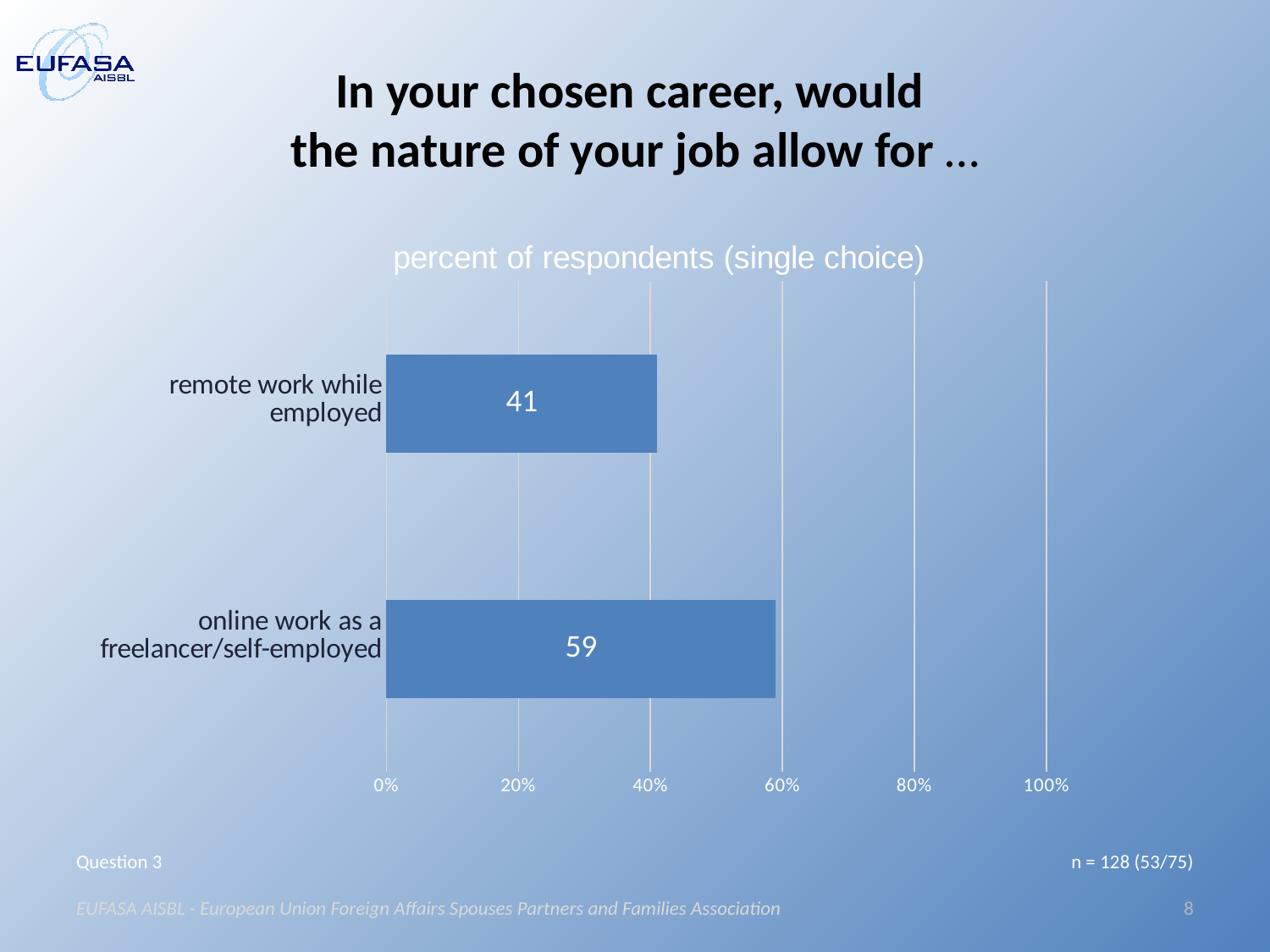
Which is larger: the value for "remote work while employed" or for "online work as a freelancer/self-employed"? online work as a freelancer/self-employed How many categories are shown in the chart? 2 What is the value for "remote work while employed"? 41 What is the maximum value shown on the x axis? 100% What kind of chart is shown on the slide? bar chart Which category has the highest value? online work as a freelancer/self-employed Which category has the lowest value? remote work while employed Is the value for "online work as a freelancer/self-employed" greater or less than 40%? greater What is the value for "online work as a freelancer/self-employed"? 59 What is the difference between the values for "online work as a freelancer/self-employed" and "remote work while employed"? 18 What is the title of the chart? percent of respondents (single choice) Is the value for "remote work while employed" greater or less than 60%? less